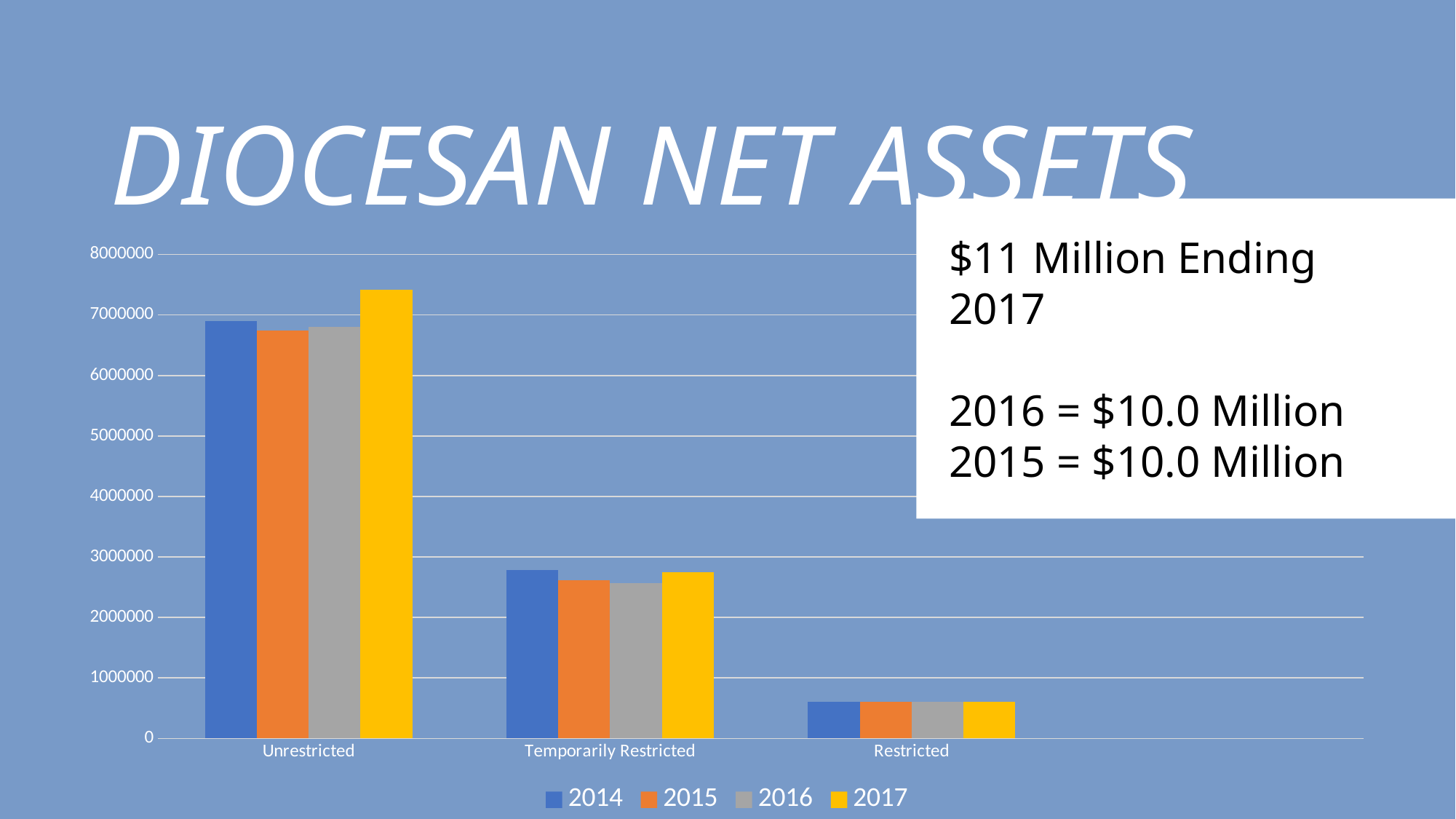
Which category has the highest net assets for 2017? Unrestricted In the Unrestricted category, is the value for 2017 larger or smaller than the value for 2014? larger What kind of chart is shown on the slide? bar chart How many categories are shown on the x axis of the chart? 3 Is the value for Unrestricted in 2017 greater or less than 7000000? greater How many series does the chart's legend list? 4 Within the Unrestricted category, which year has the tallest bar? 2017 Is the value for Temporarily Restricted in 2014 greater or less than 3000000? less Which category has the lowest net assets for 2014? Restricted Is the value for Restricted in 2016 greater or less than 1000000? less What is the title of the slide containing the chart? DIOCESAN NET ASSETS